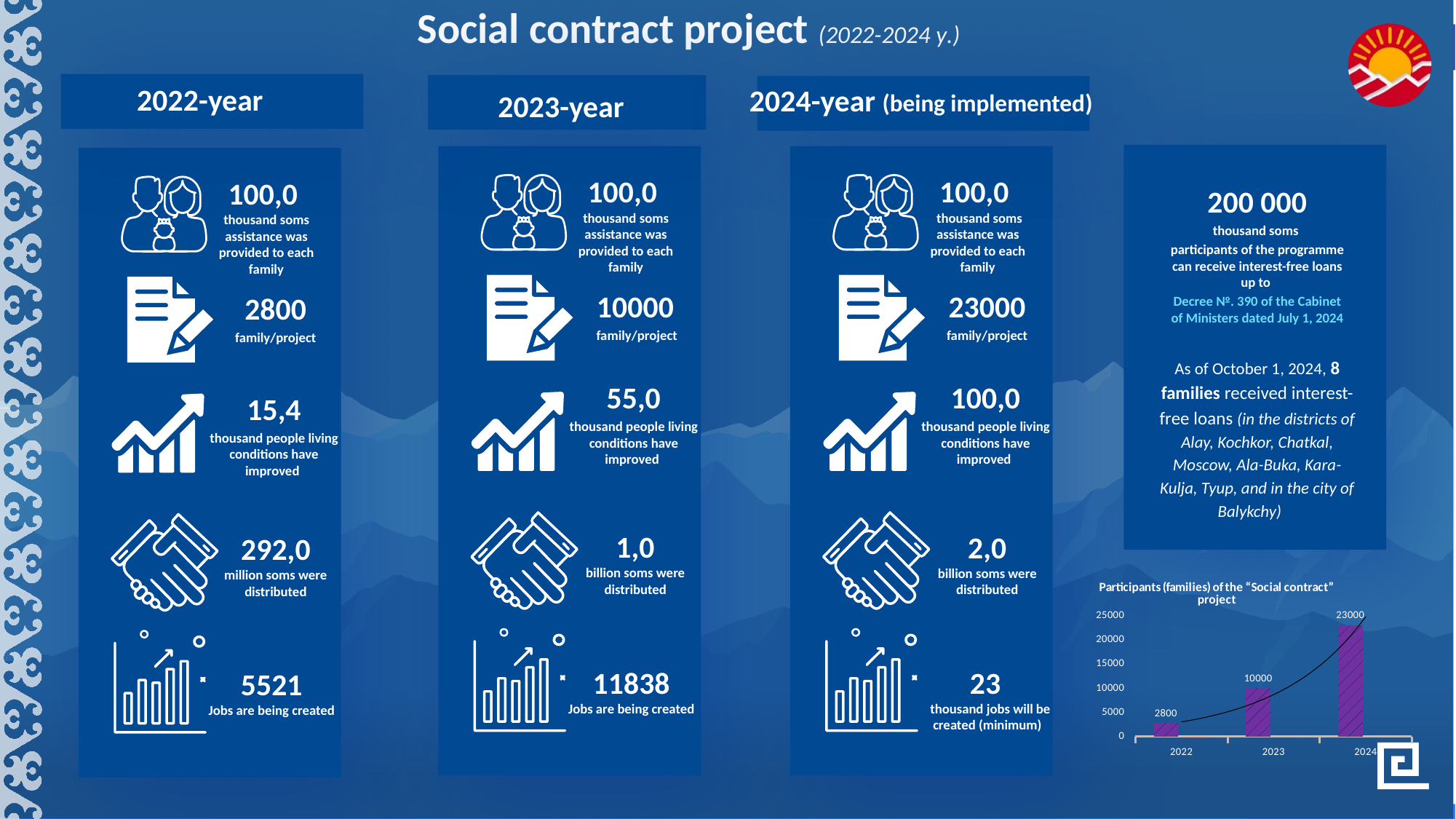
In the chart 'Participants (families) of the "Social contract" project', which year has the highest value? 2024 In the chart 'Participants (families) of the "Social contract" project', what is the difference between the values for 2024 and 2023? 13000 What kind of chart is 'Participants (families) of the "Social contract" project'? bar chart In the chart 'Participants (families) of the "Social contract" project', which year has the lowest value? 2022 In the chart 'Participants (families) of the "Social contract" project', is the value for 2024 greater or less than 20000? greater What is the value for 2022 in the chart 'Participants (families) of the "Social contract" project'? 2800 In the chart 'Participants (families) of the "Social contract" project', do the values rise or fall from 2022 to 2024? rise How many years are shown on the x axis of the chart 'Participants (families) of the "Social contract" project'? 3 In the chart 'Participants (families) of the "Social contract" project', which is larger, the value for 2022 or the value for 2023? 2023 In the chart 'Participants (families) of the "Social contract" project', what is the difference between the values for 2023 and 2022? 7200 What is the value for 2023 in the chart 'Participants (families) of the "Social contract" project'? 10000 What is the value for 2024 in the chart 'Participants (families) of the "Social contract" project'? 23000